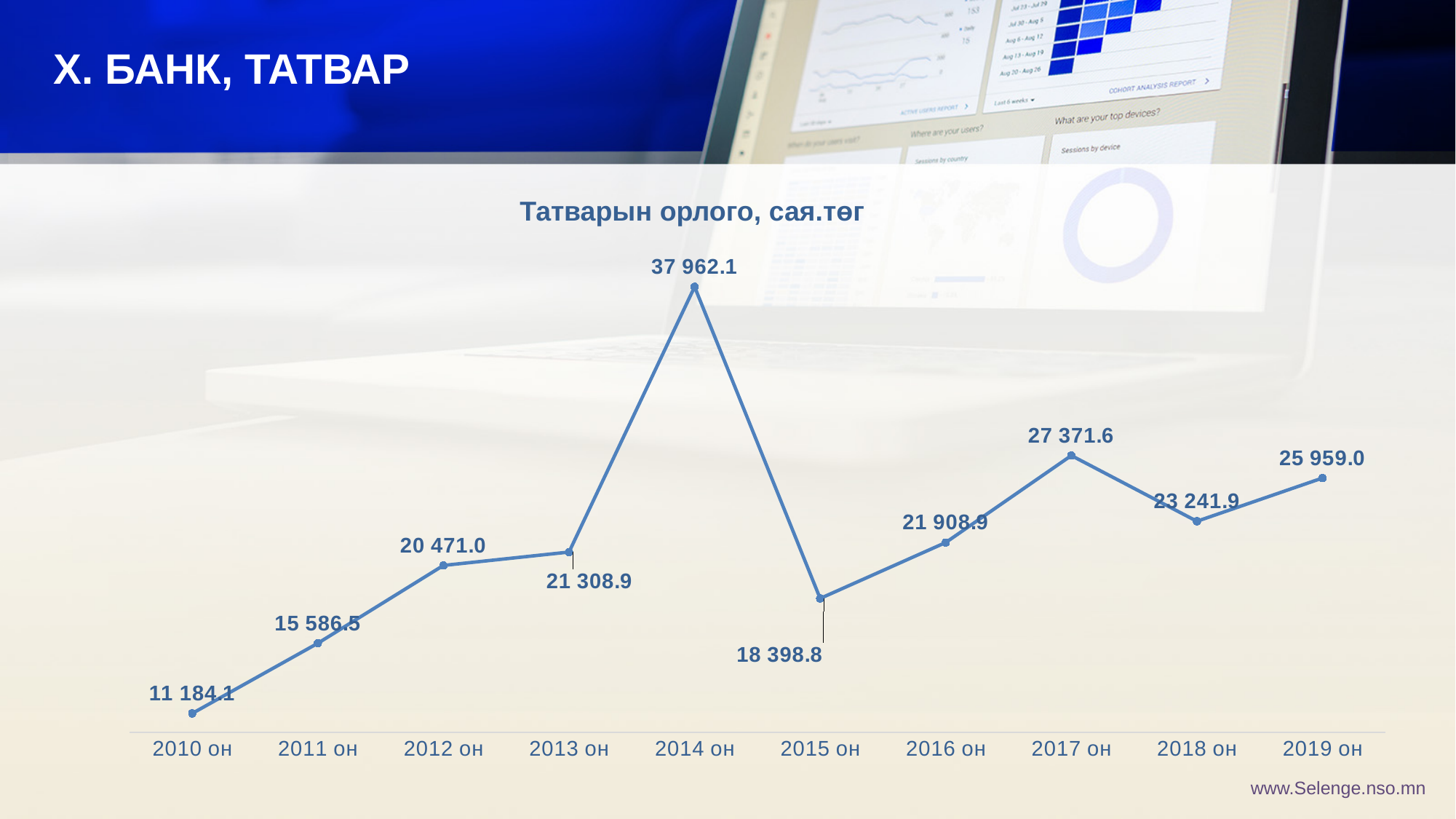
What is the value shown for 2019 он? 25 959.0 What is the title of the chart? Татварын орлого, сая.төг What is the difference between the values for 2014 он and 2013 он? 16 653.2 Which is larger, the value for 2015 он or the value for 2016 он? 2016 он What is the tax revenue value for 2014 он? 37 962.1 What is the difference between the values for 2019 он and 2018 он? 2 717.1 What is the value shown for 2017 он? 27 371.6 What kind of chart is shown on the slide? Line chart How many years are plotted on the chart? 10 Which year has the highest value on the chart? 2014 он Which year has the lowest value on the chart? 2010 он What is the value shown for 2010 он? 11 184.1